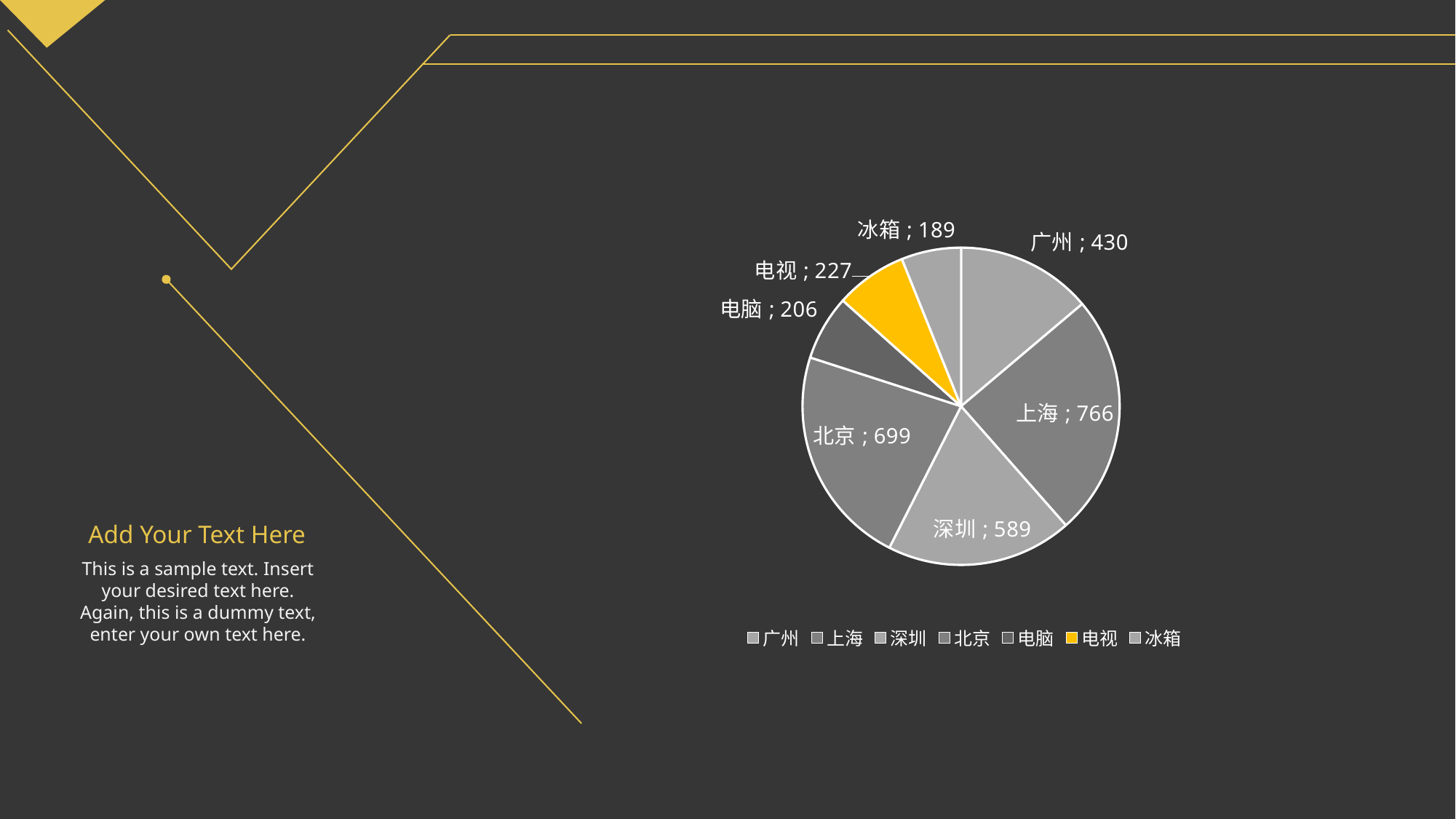
What is the total of all the values in the pie chart? 3106 What is the value for 上海 in the pie chart? 766 What is the value for 电视 in the pie chart? 227 Which category has the smallest slice in the pie chart? 冰箱 How many slices does the pie chart have? 7 What kind of chart is shown on the slide? pie chart Which category has the largest slice in the pie chart? 上海 What is the difference between the values for 上海 and 广州? 336 Which is larger, the value for 电视 or the value for 电脑? 电视 What is the difference between the values for 北京 and 深圳? 110 Which slice of the pie chart is coloured yellow? 电视 What is the value for 冰箱 in the pie chart? 189